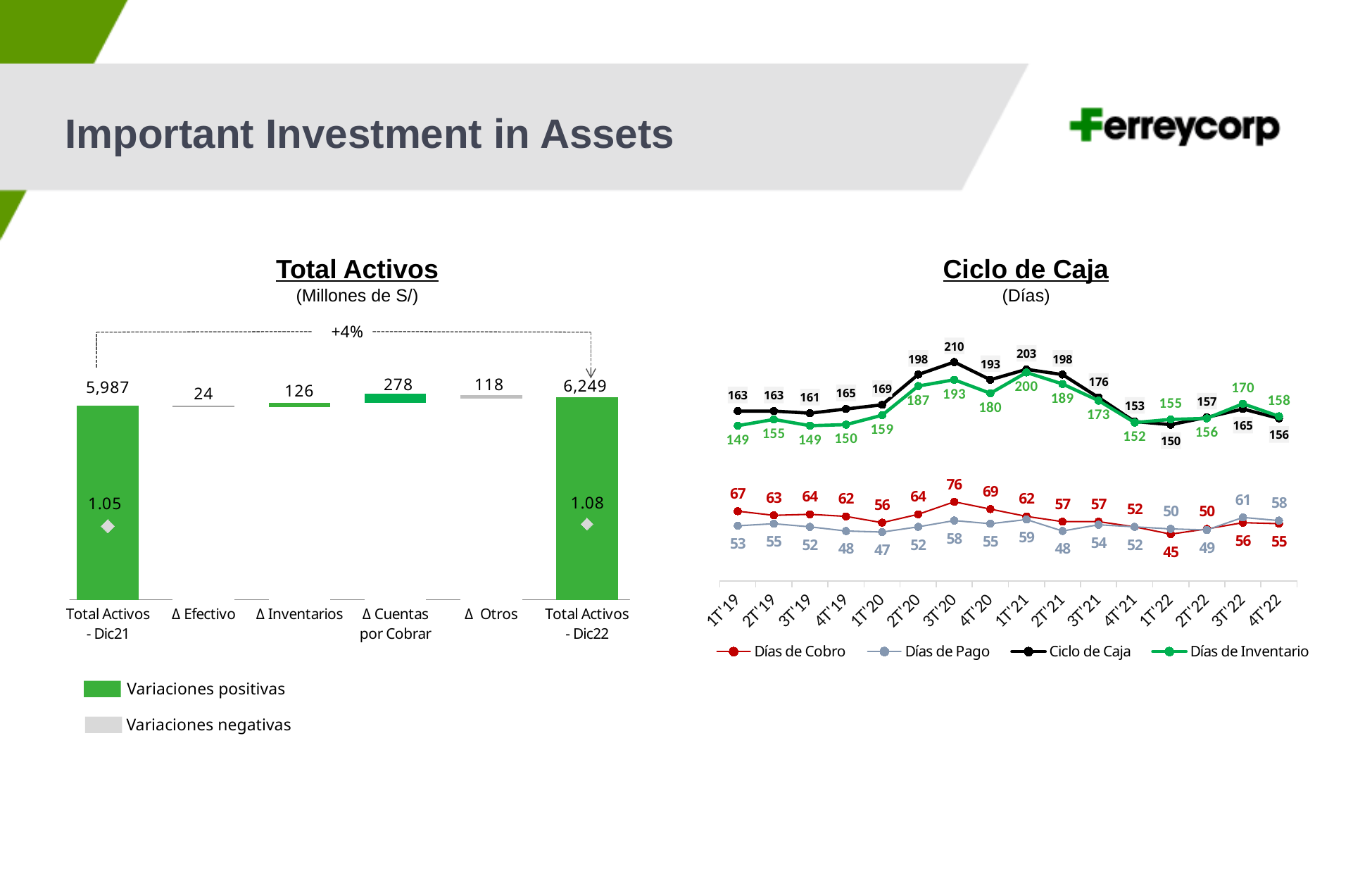
In the Total Activos chart, which of the variation bars (Δ) has the largest value? Δ Cuentas por Cobrar In the Ciclo de Caja chart, in which quarter is Días de Cobro highest? 3T'20 In the Total Activos chart, what is the value for Total Activos - Dic22? 6,249 What kind of chart is the Ciclo de Caja chart? Line chart In the Total Activos chart, what percentage change is shown between Dic21 and Dic22? +4% In the Ciclo de Caja chart, what is the difference between Días de Inventario and Días de Pago in 4T'22? 100 How many series does the legend of the Ciclo de Caja chart list? 4 In the Total Activos chart, what is the value for Δ Cuentas por Cobrar? 278 In the Ciclo de Caja chart, what is the value of Ciclo de Caja in 3T'20? 210 How many quarters are plotted on the x axis of the Ciclo de Caja chart? 16 In the Ciclo de Caja chart, in which quarter is Días de Cobro lowest? 1T'22 In the Total Activos chart, what is the difference between Total Activos - Dic22 and Total Activos - Dic21? 262